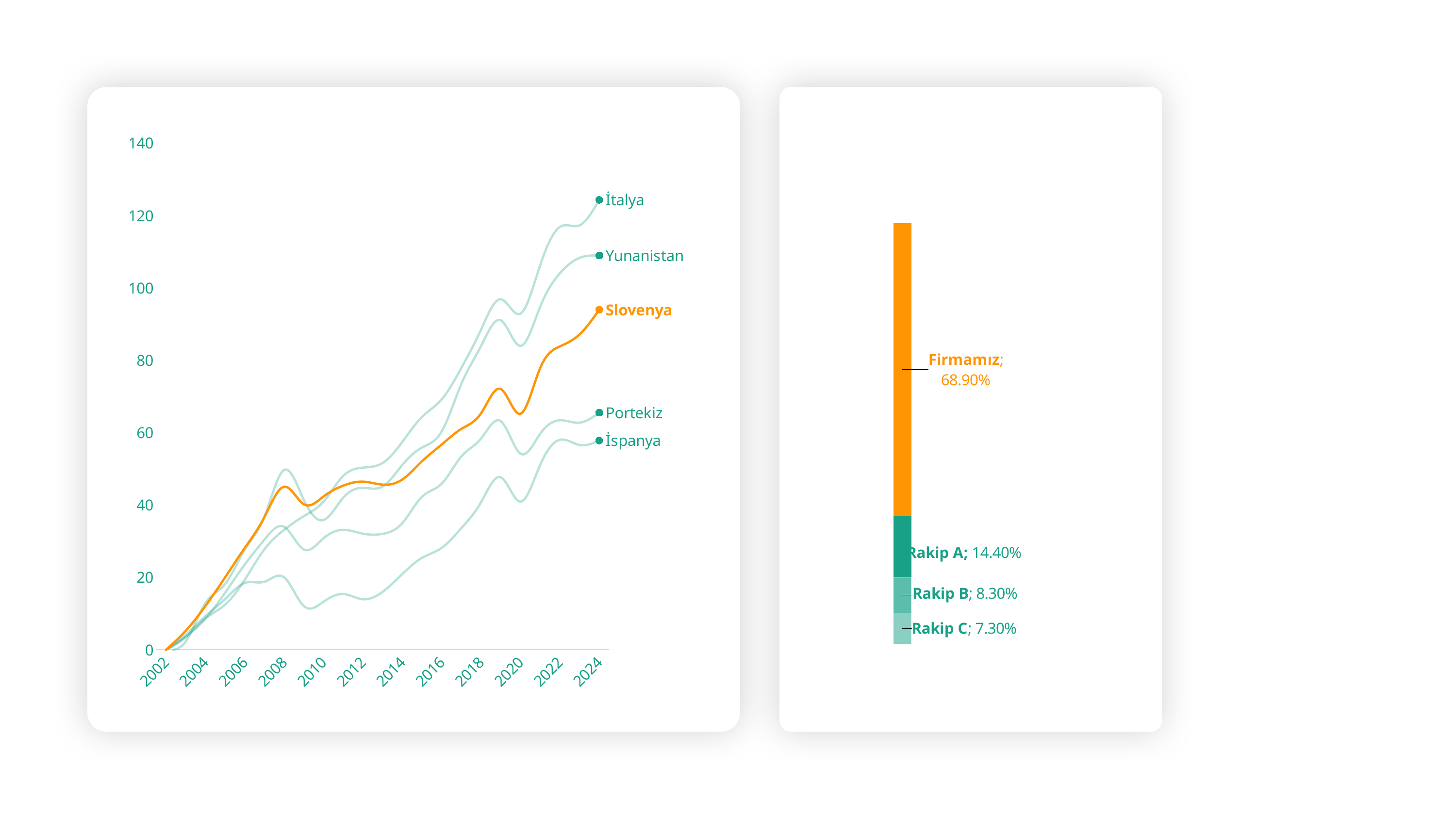
On the left chart, is the value for Slovenya in 2024 greater or less than 80? greater On the right chart, what is the difference between Firmamız and Rakip A? 54.50% On the left chart, does the İtalya line generally rise or fall from 2002 to 2024? rise What kind of chart is the left chart? line chart On the right chart, what is the value for Firmamız? 68.90% On the left chart, which country has the highest value in 2024? İtalya On the right chart, how many segments make up the stacked bar? 4 On the right chart, which is larger, Rakip B or Rakip C? Rakip B On the right chart, what is the value for Rakip A? 14.40% On the left chart, how many series (countries) are plotted? 5 On the right chart, which segment has the smallest value? Rakip C On the right chart, what is the value for Rakip C? 7.30%